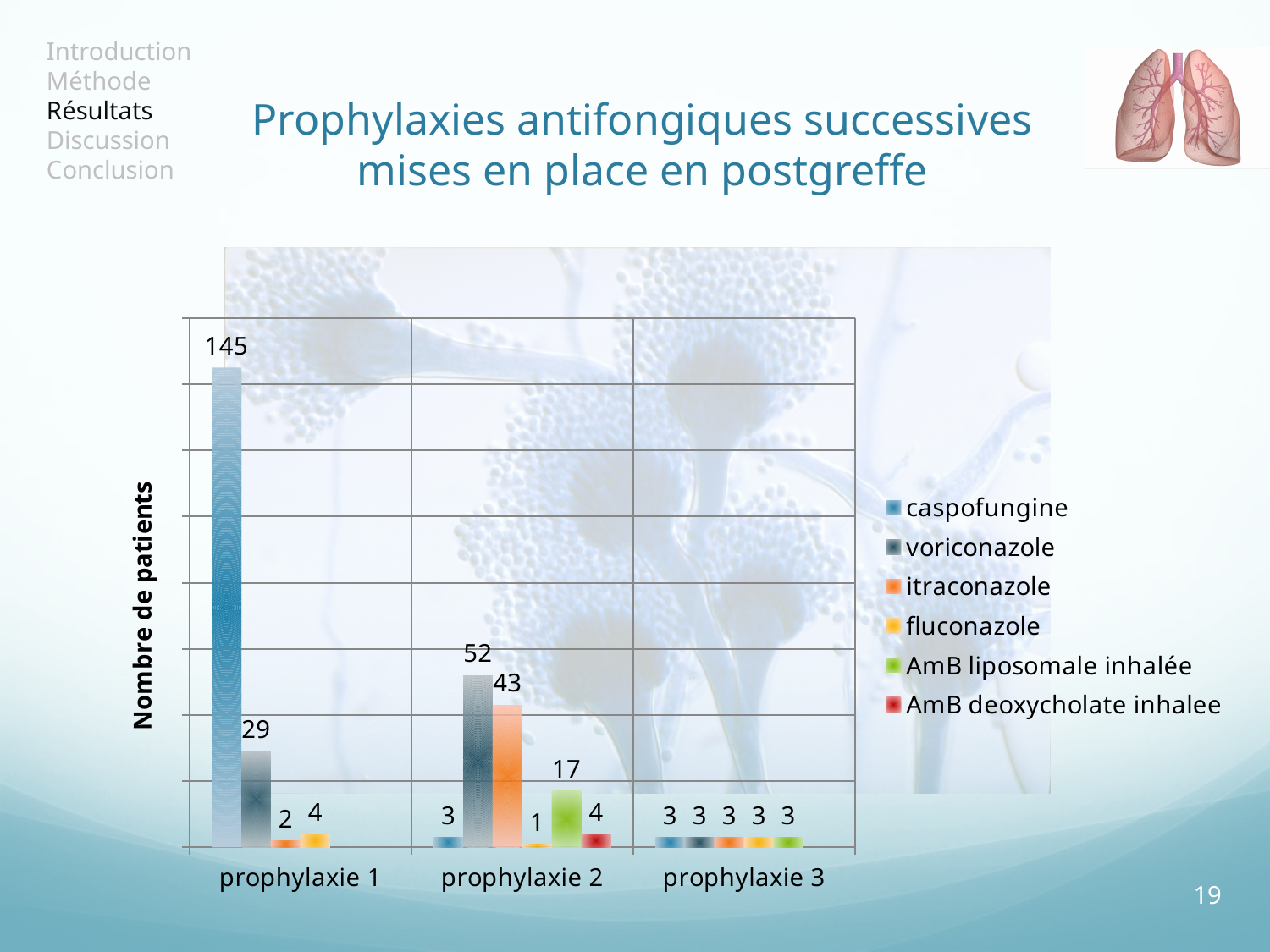
What is the difference between the caspofungine and voriconazole values in prophylaxie 1? 116 What is the label of the y axis? Nombre de patients What is the number of patients for itraconazole in prophylaxie 1? 2 What type of chart is shown on the slide? bar chart Which series has the lowest value in prophylaxie 2? fluconazole How many prophylaxie categories are shown on the x axis? 3 What is the number of patients for voriconazole in prophylaxie 2? 52 How many series does the legend list? 6 Which is larger in prophylaxie 2: voriconazole or itraconazole? voriconazole What is the number of patients for AmB liposomale inhalée in prophylaxie 2? 17 Which series has the highest value in prophylaxie 2? voriconazole What is the number of patients for caspofungine in prophylaxie 1? 145